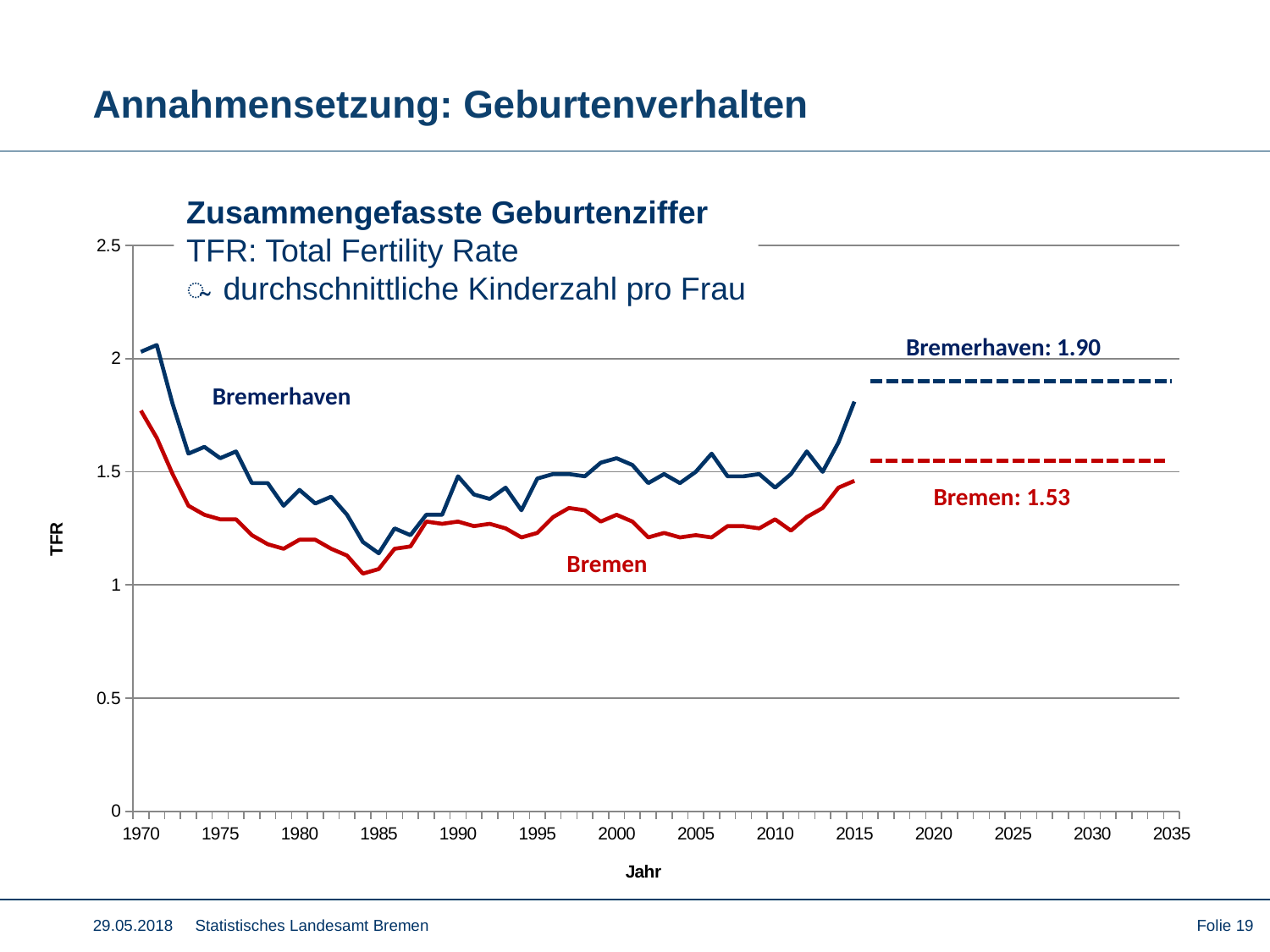
How many data series (cities) are plotted in the chart? 2 What is the assumed future TFR for Bremen shown by the dashed line? 1.53 Does the TFR for Bremerhaven rise or fall between 1970 and 1985? fall What kind of chart is shown on the slide? line chart Which has the higher assumed future TFR, Bremerhaven or Bremen? Bremerhaven In 1990, which line is higher, Bremerhaven or Bremen? Bremerhaven Is the TFR for Bremen in 1985 greater or less than 1.5? less Is the TFR for Bremen in 1970 greater or less than 1.5? greater What is the assumed future TFR for Bremerhaven shown by the dashed line? 1.90 What is the difference between the assumed TFR for Bremerhaven (1.90) and for Bremen (1.53)? 0.37 Is the TFR for Bremerhaven in 2015 greater or less than 1.5? greater What is the label of the y axis? TFR